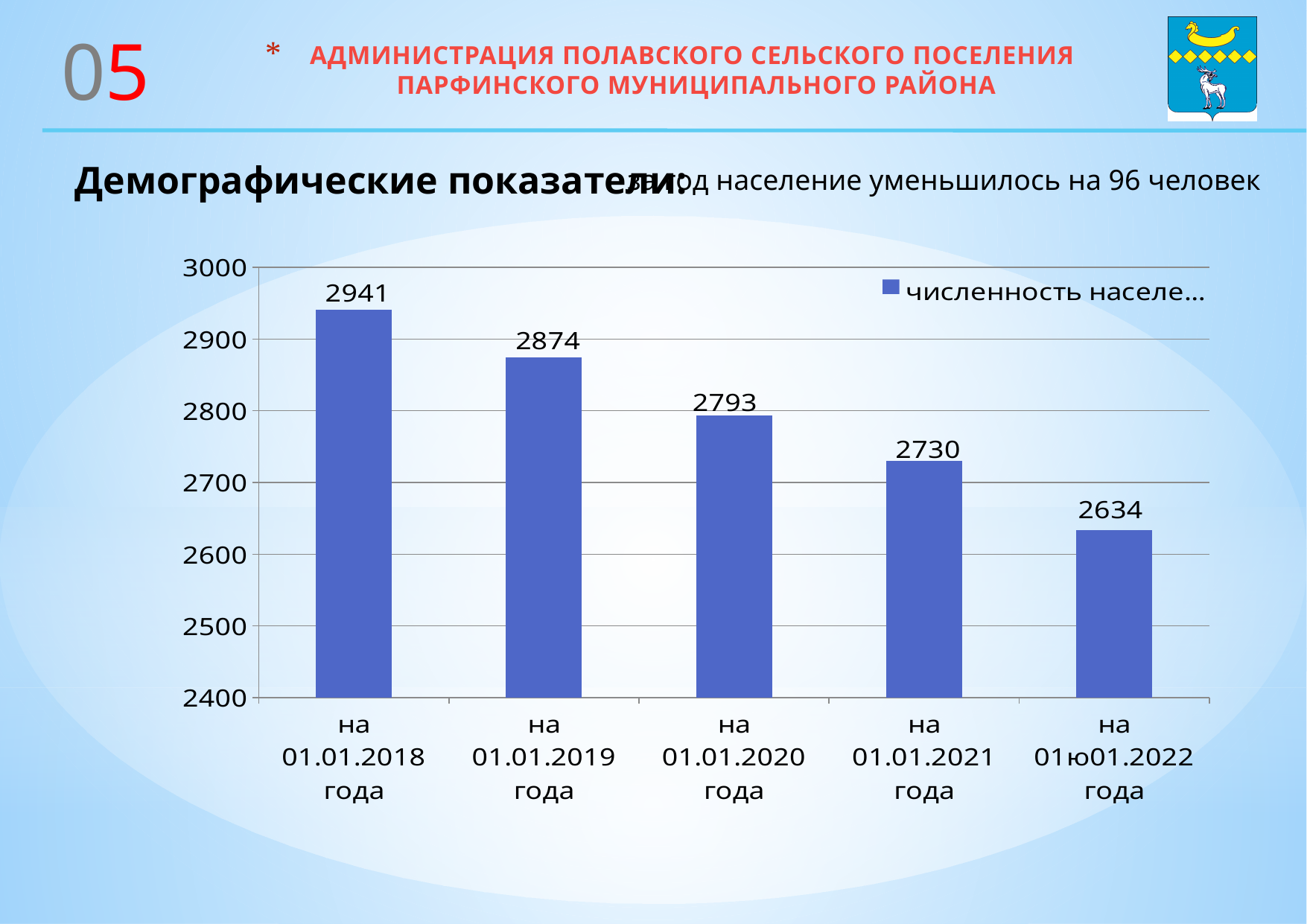
What is the population value shown for 01.01.2018? 2941 Do the values rise or fall from 01.01.2018 to 01.01.2022? fall Which date has the highest population value? 01.01.2018 What is the population value shown for 01.01.2020? 2793 How many bars are shown in the chart? 5 Which date has the lowest population value? 01.01.2022 What is the difference between the population on 01.01.2021 and on 01.01.2022? 96 What is the population value shown for 01.01.2022? 2634 What kind of chart is shown on the slide? bar chart Is the value for 01.01.2020 greater or less than 2800? less Which is larger, the population on 01.01.2019 or on 01.01.2021? 01.01.2019 What is the difference between the population on 01.01.2018 and on 01.01.2019? 67